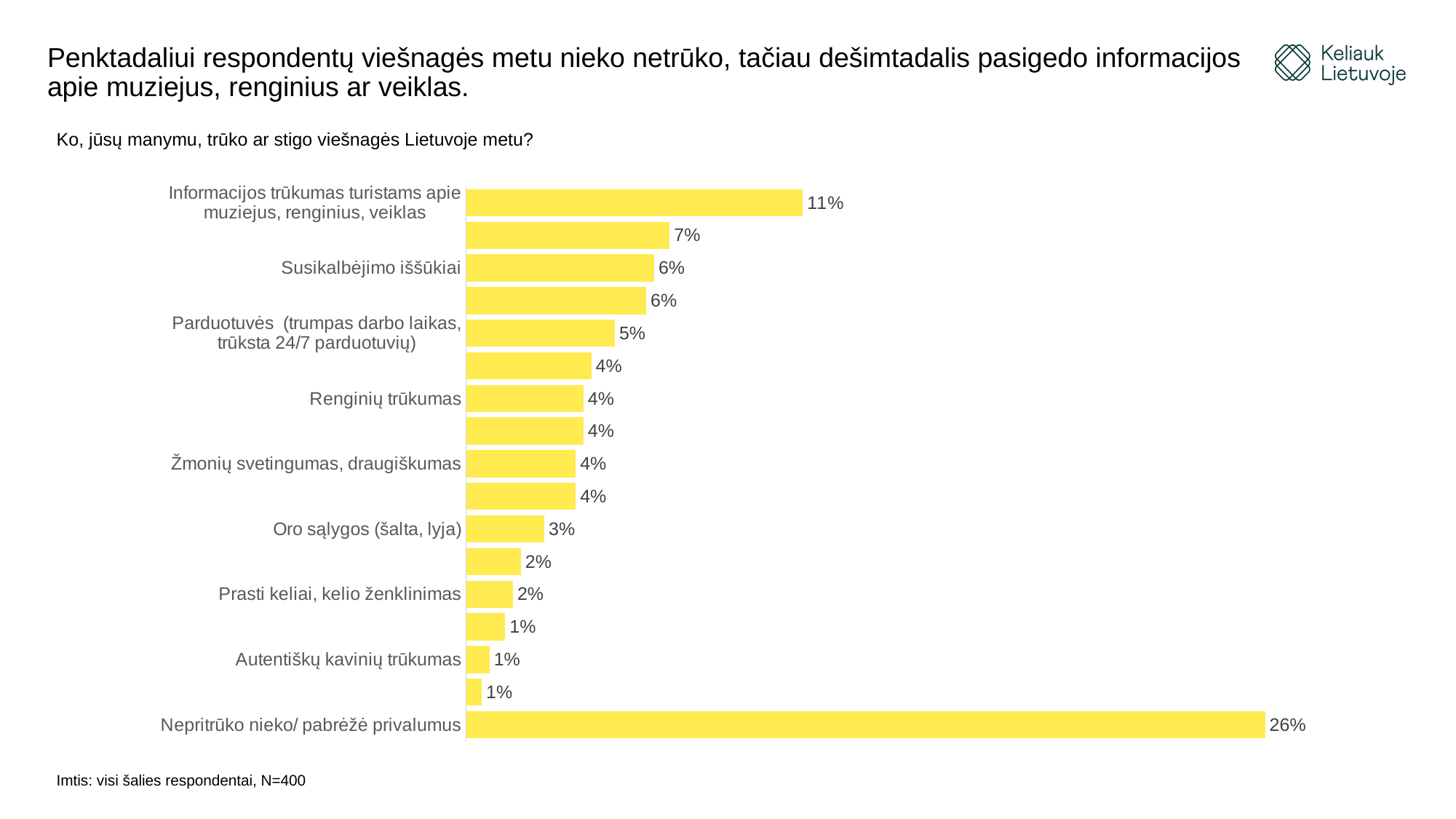
What kind of chart is shown on the slide? bar chart What is the value for "Susikalbėjimo iššūkiai"? 6% What is the value for "Parduotuvės (trumpas darbo laikas, trūksta 24/7 parduotuvių)"? 5% What is the difference between the values for "Nepritrūko nieko/ pabrėžė privalumus" and "Informacijos trūkumas turistams apie muziejus, renginius, veiklas"? 15% What is the value for "Nepritrūko nieko/ pabrėžė privalumus"? 26% Which is larger, the value for "Susikalbėjimo iššūkiai" or the value for "Oro sąlygos (šalta, lyja)"? Susikalbėjimo iššūkiai Which category has the highest value? Nepritrūko nieko/ pabrėžė privalumus What question is shown as the chart's title above the bars? Ko, jūsų manymu, trūko ar stigo viešnagės Lietuvoje metu? What is the value for "Autentiškų kavinių trūkumas"? 1% What is the value for "Oro sąlygos (šalta, lyja)"? 3% What is the value for "Informacijos trūkumas turistams apie muziejus, renginius, veiklas"? 11% How many bars are plotted in the chart? 17